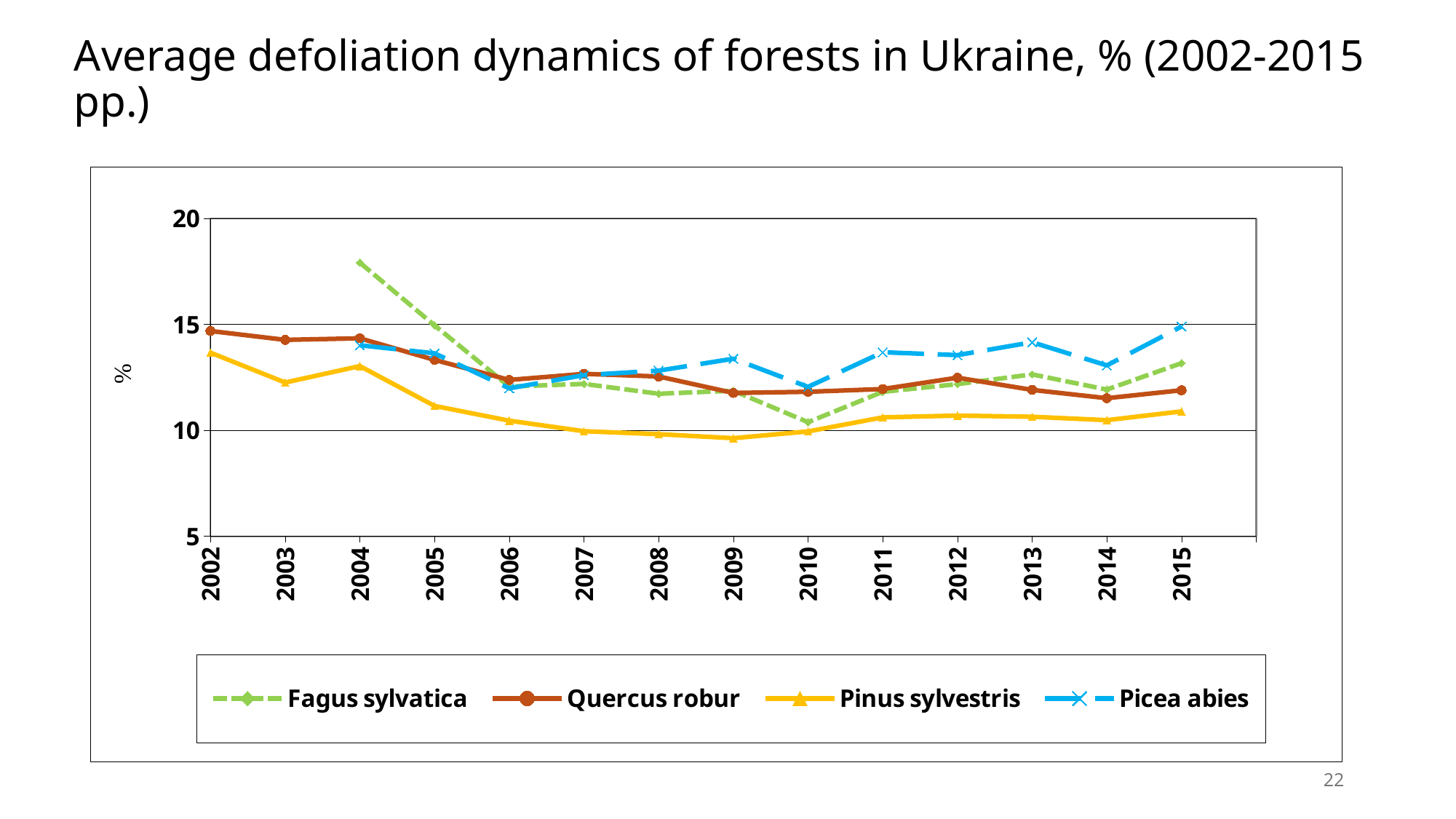
Is the value for Pinus sylvestris in 2009 greater or less than 10? less Which series has the lowest value in 2009? Pinus sylvestris Which series has the highest value in 2004? Fagus sylvatica What is the label on the y axis? % Which series is drawn with a green dashed line? Fagus sylvatica How many years are plotted along the x axis? 14 Which is larger in 2015, the value for Picea abies or the value for Pinus sylvestris? Picea abies How many series does the legend list? 4 Is the value for Pinus sylvestris in 2002 greater or less than 10? greater Does the value for Pinus sylvestris rise or fall from 2002 to 2009? fall Is the value for Fagus sylvatica in 2004 greater or less than 15? greater What kind of chart is shown on the slide? line chart